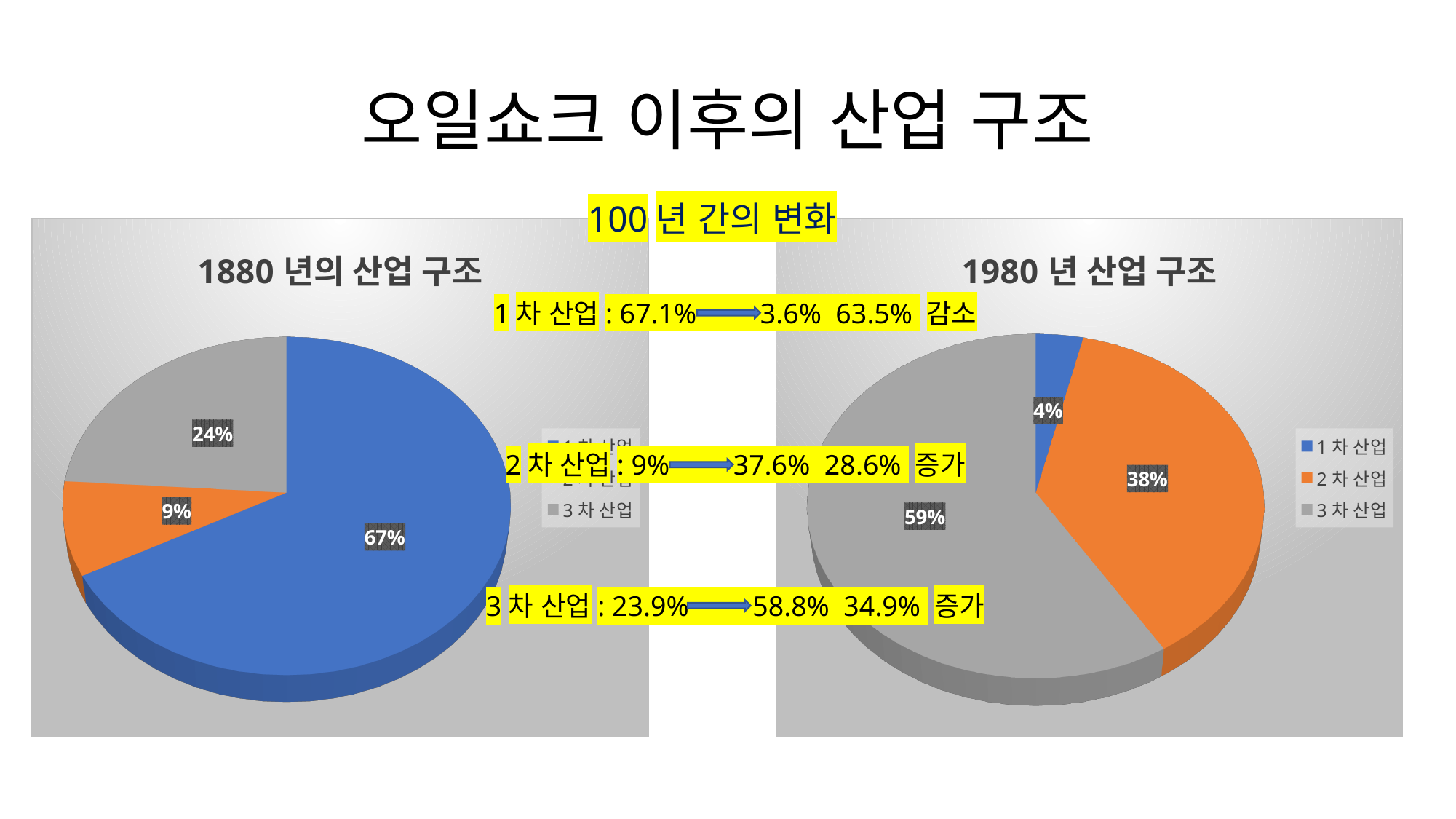
In the "1880 년의 산업 구조" chart, what is the value shown for 3 차 산업? 24% What kind of chart is the "1880 년의 산업 구조" chart? pie chart In the "1880 년의 산업 구조" chart, what is the value shown for 1 차 산업? 67% How many entries does the legend of the "1980 년 산업 구조" chart list? 3 In the "1880 년의 산업 구조" chart, which category has the smallest slice? 2 차 산업 In the "1980 년 산업 구조" chart, what is the value shown for 1 차 산업? 4% In the "1980 년 산업 구조" chart, what is the difference between the 3 차 산업 and 2 차 산업 slices? 21% In the "1980 년 산업 구조" chart, what is the value shown for 2 차 산업? 38% In the "1980 년 산업 구조" chart, which category has the largest slice? 3 차 산업 In the "1980 년 산업 구조" chart, what colour is the 2 차 산업 slice? orange How many slices does the "1980 년 산업 구조" pie chart have? 3 In the "1880 년의 산업 구조" chart, which is larger, the 2 차 산업 slice or the 3 차 산업 slice? 3 차 산업